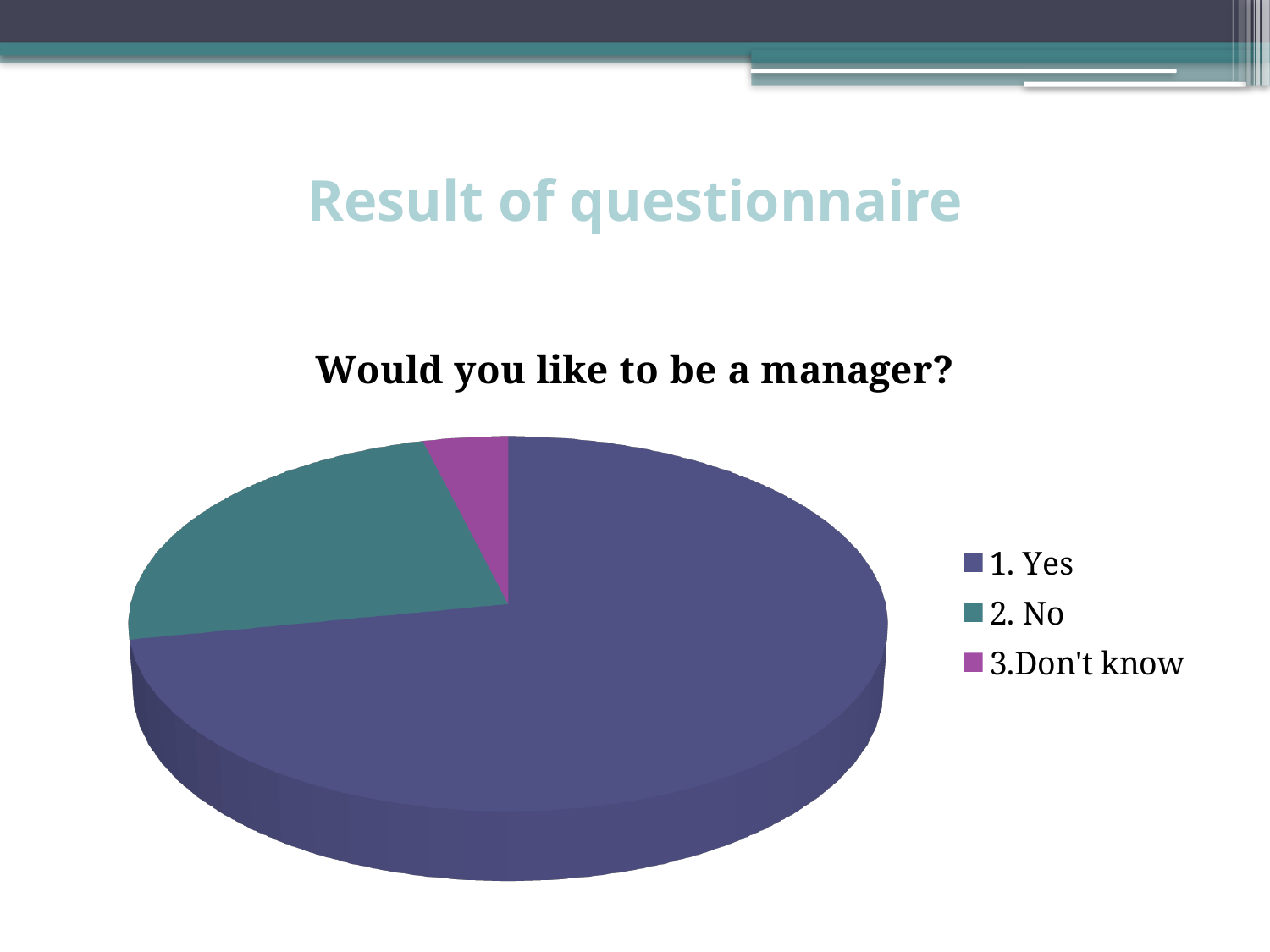
What kind of chart is shown on the slide? pie chart Which slice is larger, "1. Yes" or "2. No"? 1. Yes Does the "1. Yes" slice take up more or less than half of the pie? more Which category has the largest slice of the pie? 1. Yes What is the title of the chart? Would you like to be a manager? How many categories does the legend list? 3 How many slices does the pie chart have? 3 Which legend entry is shown in purple/magenta? 3.Don't know Which category has the smallest slice of the pie? 3.Don't know Which slice is larger, "2. No" or "3.Don't know"? 2. No